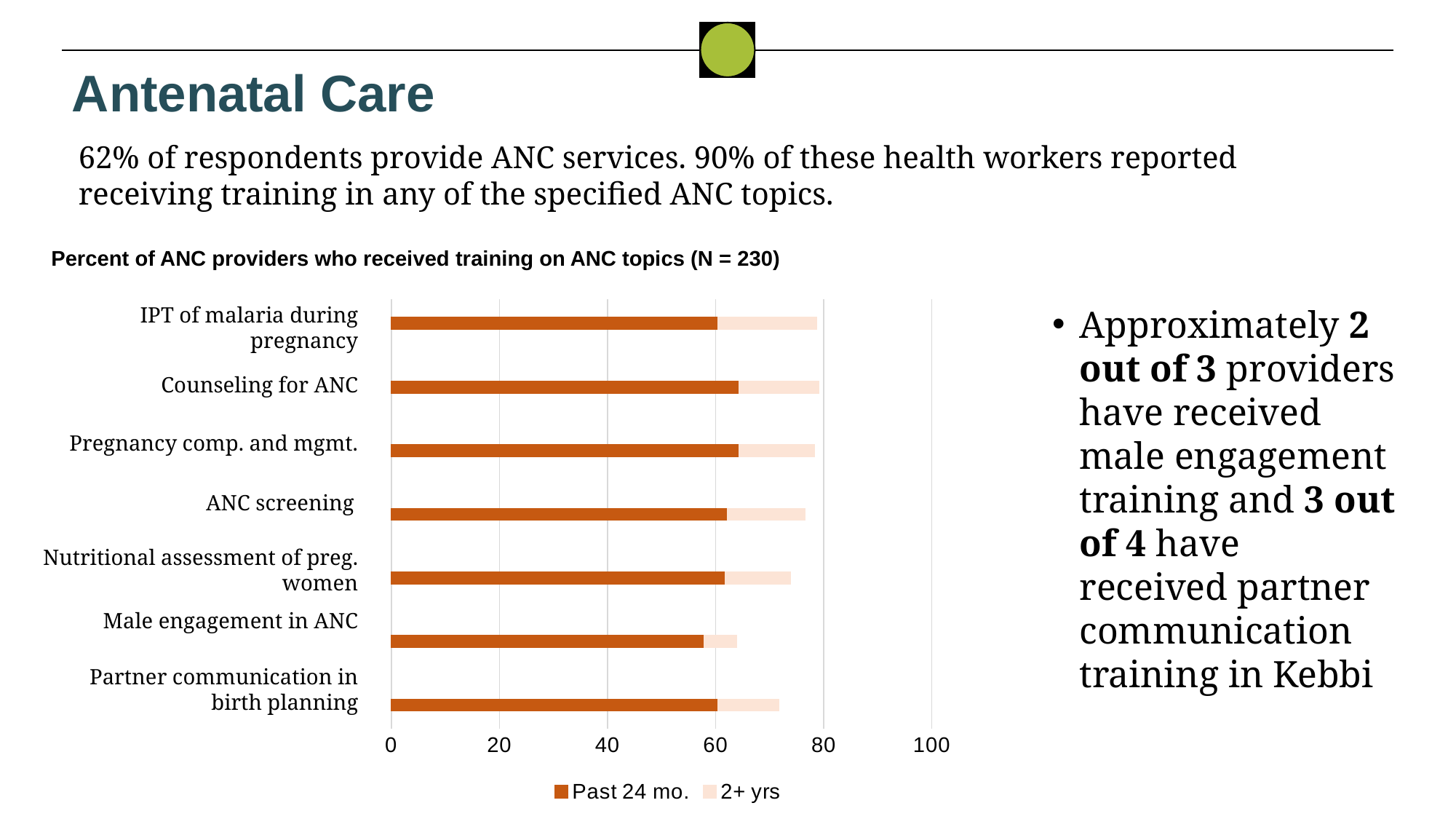
What is the title of the chart? Percent of ANC providers who received training on ANC topics (N = 230) How many ANC topics (categories) are plotted in the chart? 7 Is the total bar for Nutritional assessment of preg. women greater or less than 80? less What kind of chart is shown on the slide? bar chart What are the two series named in the chart legend? Past 24 mo. and 2+ yrs How many series does the chart legend list? 2 Is the total bar for Male engagement in ANC greater or less than 80? less Which has the longer total bar: Partner communication in birth planning or Male engagement in ANC? Partner communication in birth planning Which ANC topic has the shortest total bar? Male engagement in ANC Which has the longer total bar: Nutritional assessment of preg. women or Male engagement in ANC? Nutritional assessment of preg. women Is the total bar for Partner communication in birth planning greater or less than 60? greater